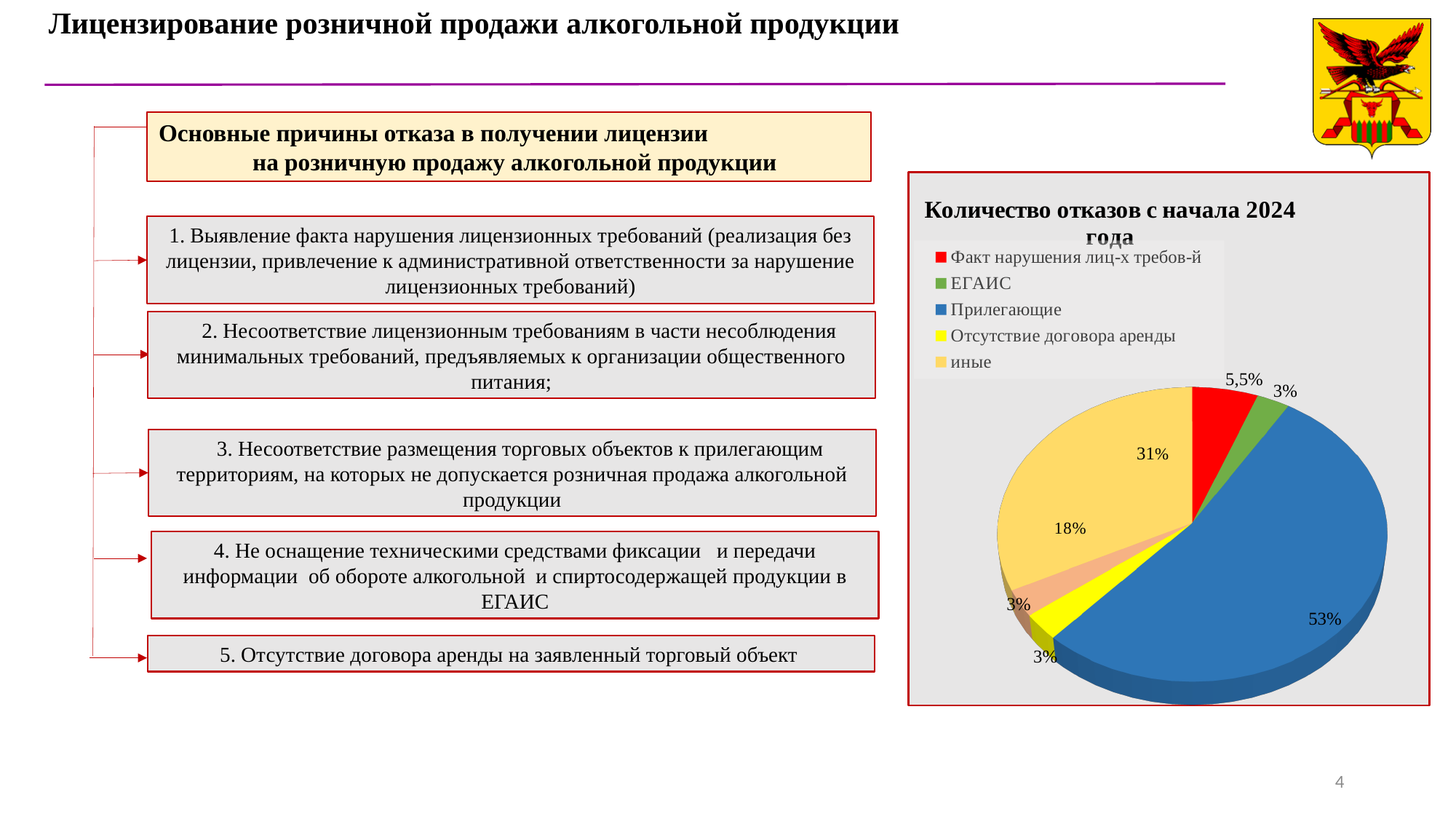
Which category has the largest slice of the pie? Прилегающие What is the difference between the share for Прилегающие and the share for Факт нарушения лиц-х требов-й? 47,5% What share of the pie does the slice for Факт нарушения лиц-х требов-й have? 5,5% What share of the pie does the slice for ЕГАИС have? 3% What colour represents Прилегающие in the pie chart legend? blue How many entries does the legend of the pie chart list? 5 What share of the pie does the slice for Прилегающие have? 53% Is the share for Прилегающие greater or less than 50%? greater What share of the pie does the slice for Отсутствие договора аренды have? 3% Which is larger: the slice for Прилегающие or the slice for Факт нарушения лиц-х требов-й? Прилегающие What is the title of the pie chart? Количество отказов с начала 2024 года What kind of chart is shown on the slide? pie chart